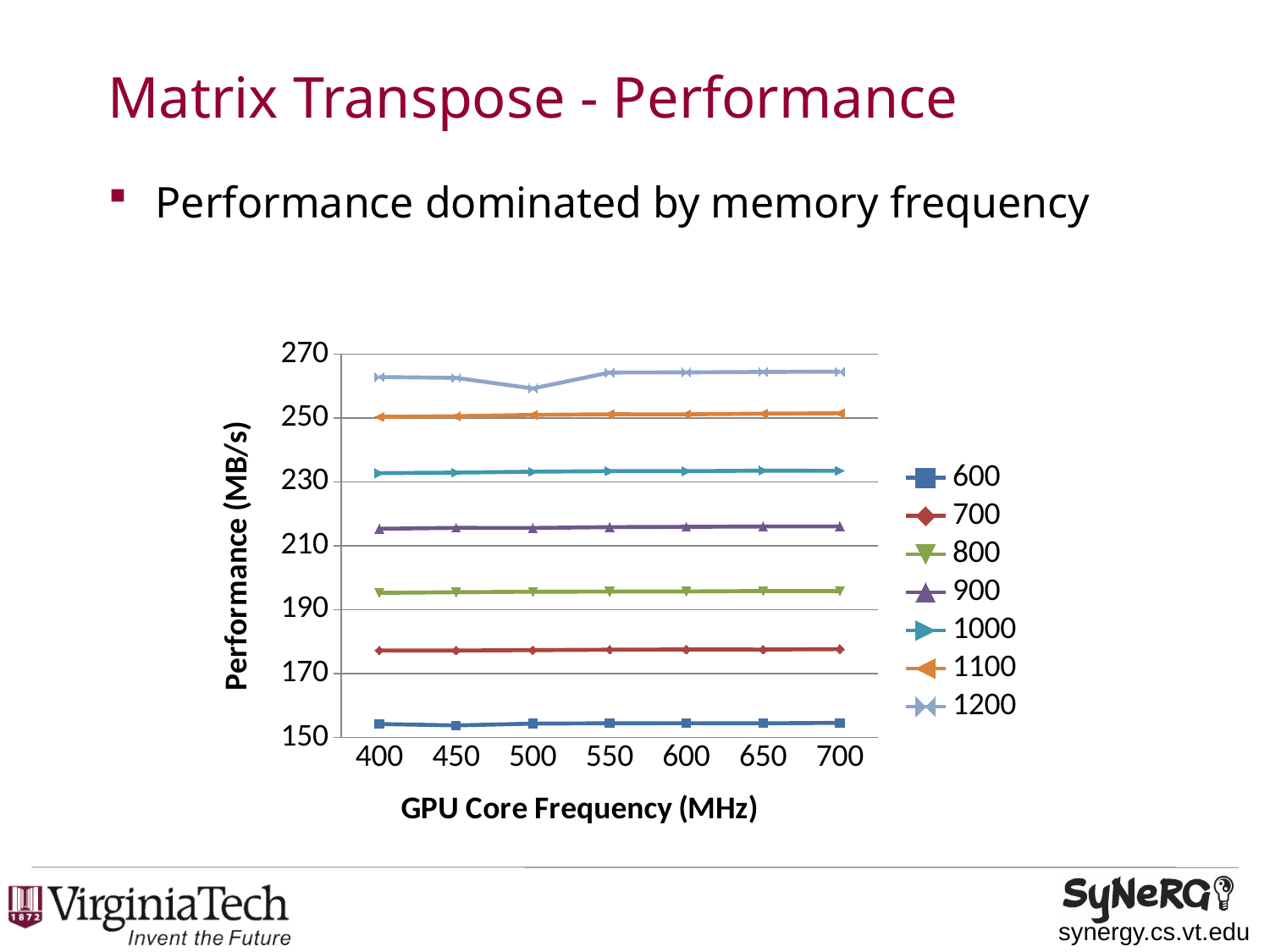
Is the value for the 1200 series at 400 MHz greater or less than 250? greater Which series has the lowest performance across the chart? 600 Is the value for the 600 series at 700 MHz greater or less than 170? less What is the label of the x axis? GPU Core Frequency (MHz) Which series has the highest performance across the chart? 1200 What is the label of the y axis? Performance (MB/s) What kind of chart is shown on the slide? line chart Is the value for the 900 series at 500 MHz greater or less than 210? greater How many GPU core frequency points are plotted along the x axis? 7 At 600 MHz, which series has the higher performance, 1000 or 800? 1000 How many series does the legend list? 7